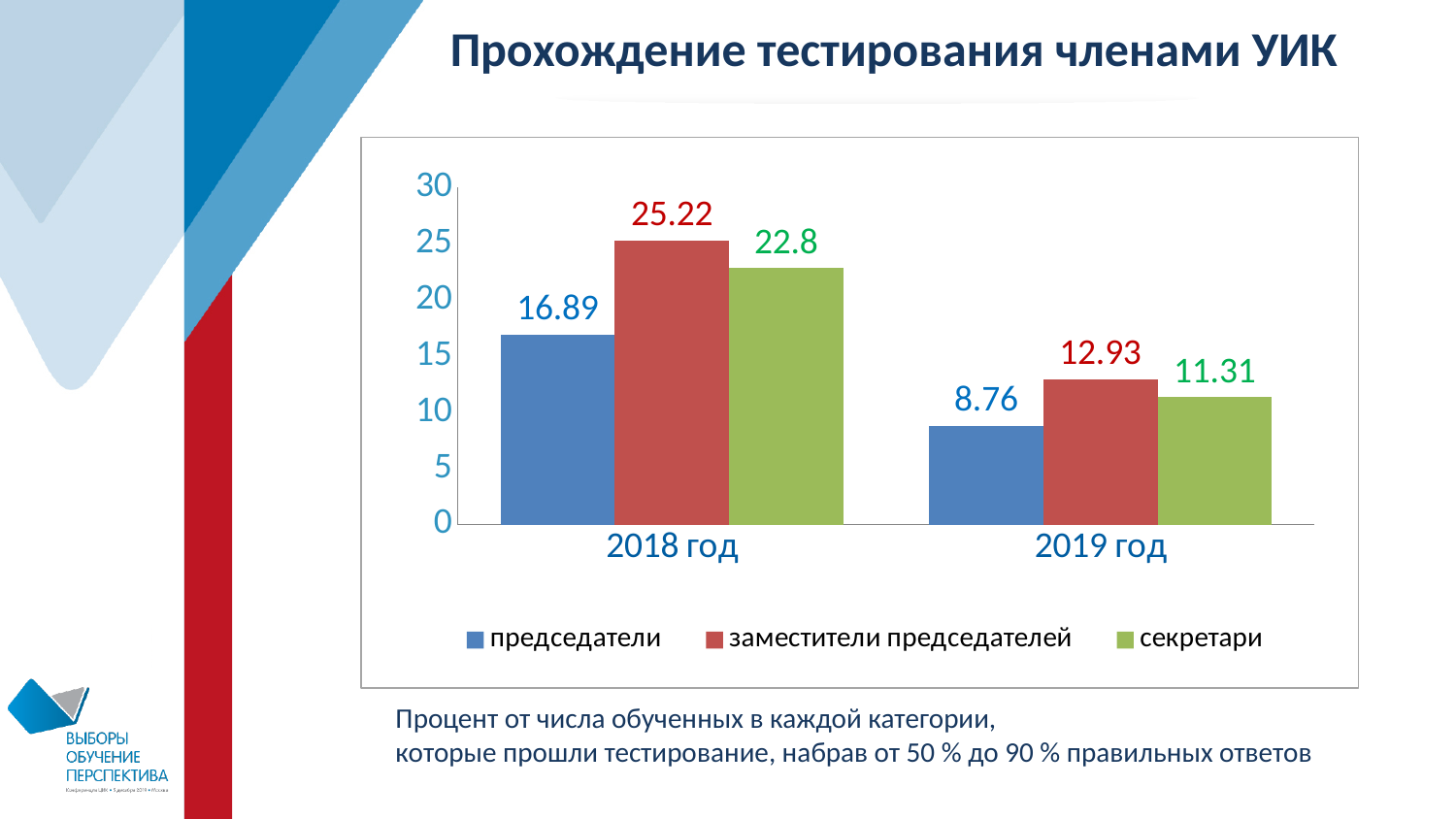
What is the value for заместители председателей in 2019 год? 12.93 What is the value for председатели in 2018 год? 16.89 What is the difference between the заместители председателей values for 2018 год and 2019 год? 12.29 What kind of chart is shown on the slide? bar chart Do the values for секретари rise or fall from 2018 год to 2019 год? fall How many series does the legend list? 3 What is the value for секретари in 2018 год? 22.8 Which series has the highest value in 2019 год? заместители председателей Is the value for председатели in 2019 год greater or less than 10? less Which is larger: секретари in 2018 год or заместители председателей in 2019 год? секретари in 2018 год Which series has the lowest value in 2018 год? председатели How many categories are shown on the x axis? 2